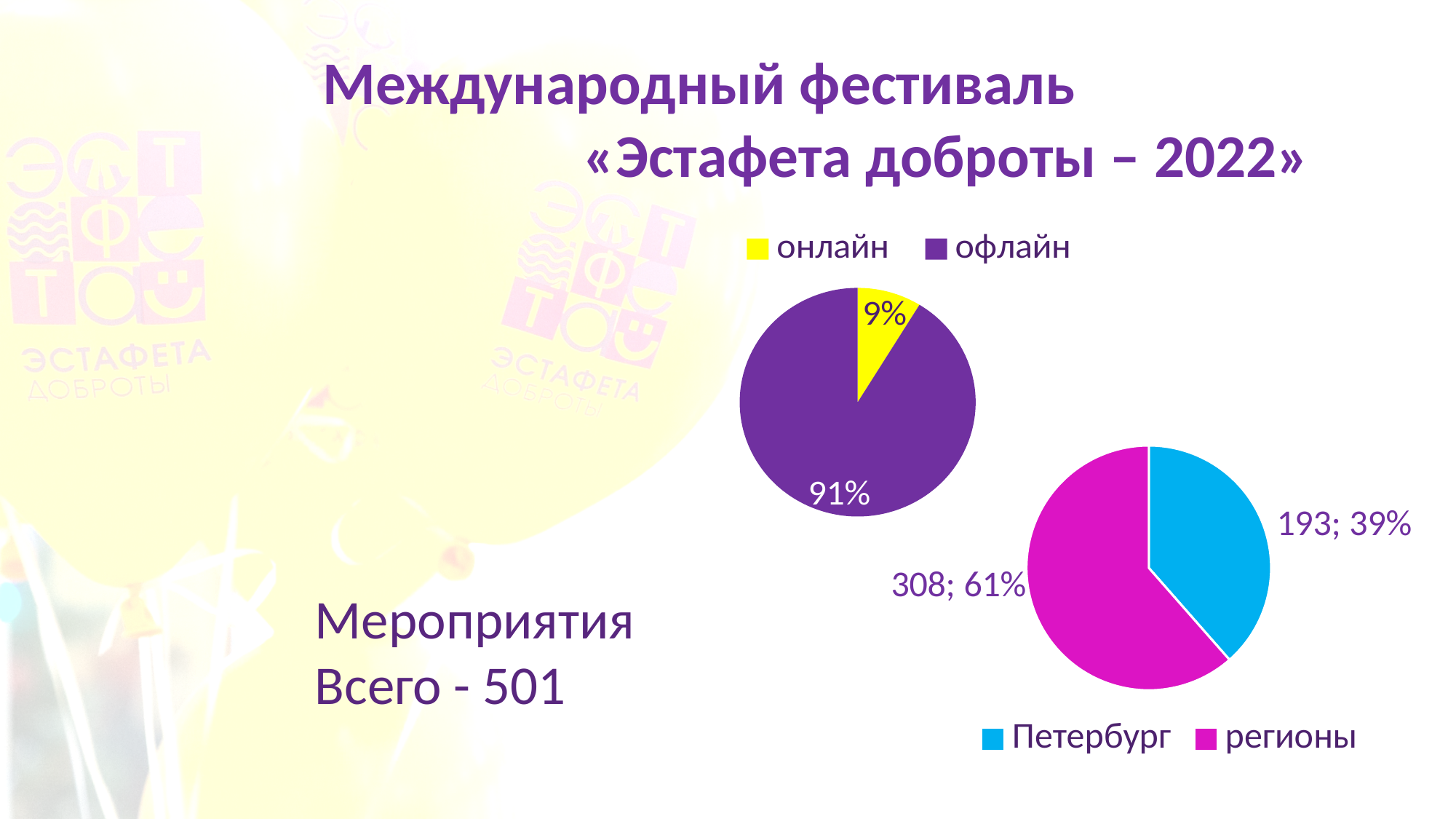
In the lower pie chart (Петербург/регионы), what is the difference between the counts for регионы and Петербург? 115 In the lower pie chart (Петербург/регионы), what value is labelled for Петербург? 193; 39% In the upper pie chart (онлайн/офлайн), which slice is the smallest? онлайн In the upper pie chart (онлайн/офлайн), what share is labelled for онлайн? 9% In the lower pie chart (Петербург/регионы), what value is labelled for регионы? 308; 61% In the upper pie chart (онлайн/офлайн), which slice is the largest? офлайн In the upper pie chart (онлайн/офлайн), how many entries does the legend list? 2 In the lower pie chart (Петербург/регионы), what colour is the регионы slice? magenta What kind of chart is the lower chart (Петербург/регионы)? pie chart In the upper pie chart (онлайн/офлайн), what share is labelled for офлайн? 91% In the lower pie chart (Петербург/регионы), what is the total of the two counts shown? 501 In the lower pie chart (Петербург/регионы), which slice is larger, Петербург or регионы? регионы